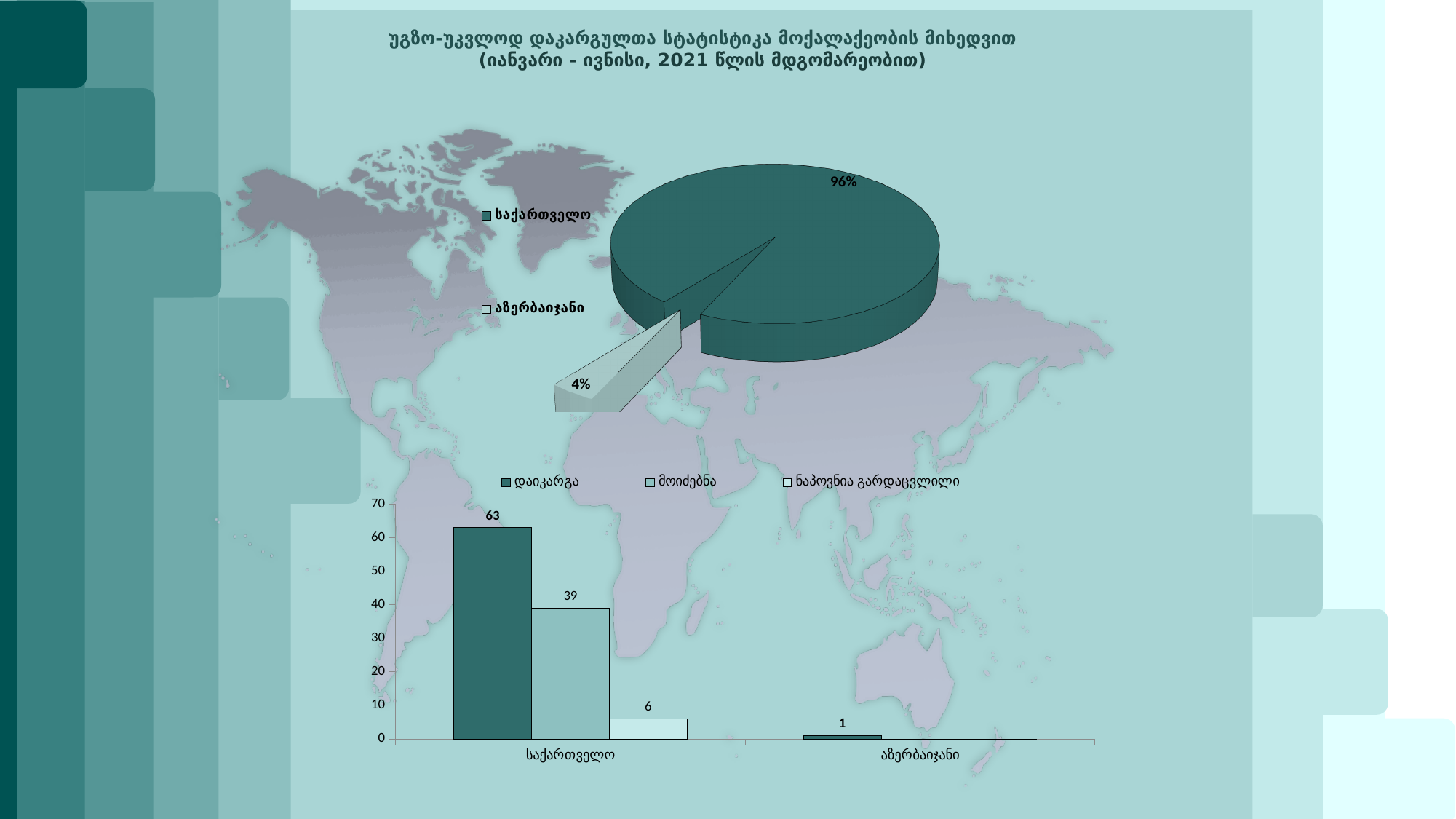
In the bar chart at the bottom of the slide, what is the value of მოიძებნა for საქართველო? 39 What kind of chart is the chart at the bottom of the slide? bar chart In the bar chart at the bottom of the slide, which series has the lowest value for საქართველო? ნაპოვნია გარდაცვლილი In the bar chart at the bottom of the slide, what is the value of ნაპოვნია გარდაცვლილი for საქართველო? 6 In the pie chart at the top of the slide, what share does საქართველო have? 96% In the bar chart at the bottom of the slide, what is the difference between დაიკარგა and მოიძებნა for საქართველო? 24 How many series does the legend of the bar chart at the bottom of the slide list? 3 In the bar chart at the bottom of the slide, what is the value of დაიკარგა for აზერბაიჯანი? 1 How many entries does the legend of the pie chart at the top of the slide list? 2 In the pie chart at the top of the slide, which category has the larger slice? საქართველო In the pie chart at the top of the slide, what share does აზერბაიჯანი have? 4% In the bar chart at the bottom of the slide, what is the value of დაიკარგა for საქართველო? 63